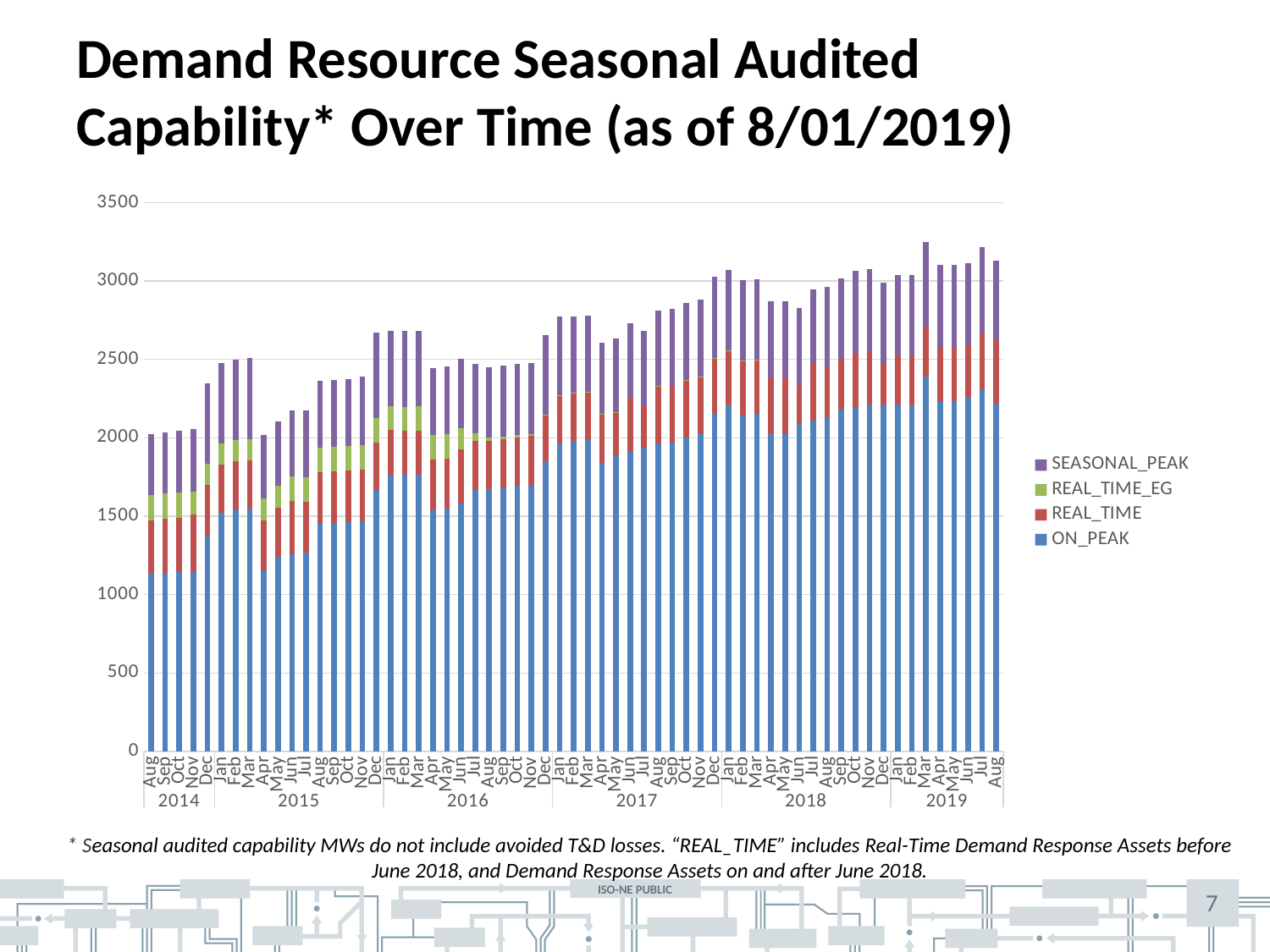
Which series is listed last in the legend? ON_PEAK What kind of chart is shown on the slide? Stacked bar chart Is the total value for Mar 2019 greater or less than 3000? greater Is the total value for Aug 2015 greater or less than 2500? less Which has the larger total, Nov 2014 or Dec 2014? Dec 2014 What is the title of the chart on the slide? Demand Resource Seasonal Audited Capability* Over Time (as of 8/01/2019) Do the total values generally rise or fall from 2014 to 2019? Rise Is the total value for Dec 2014 greater or less than 2000? greater How many series does the legend list? 4